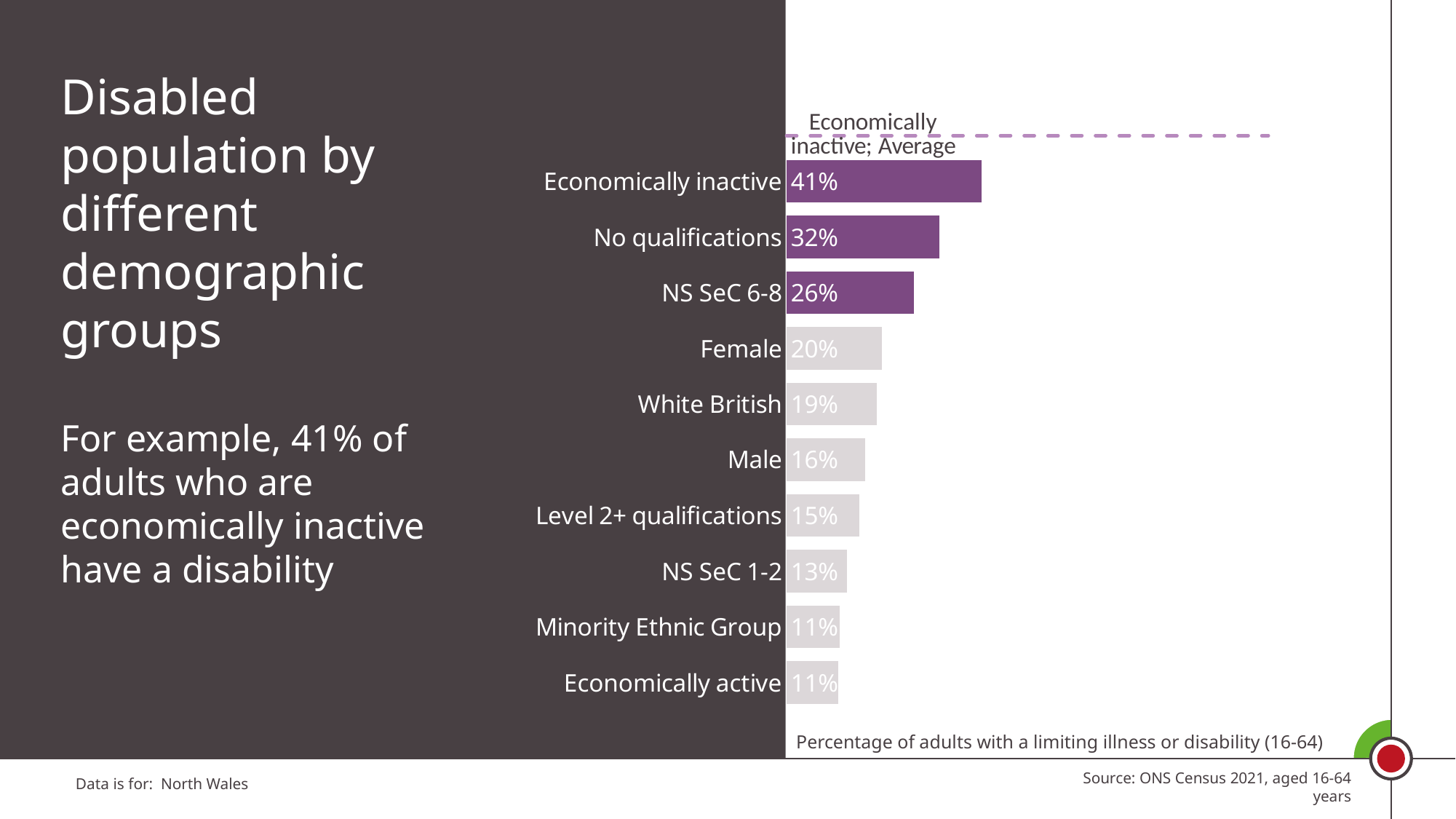
Which is larger, the value for 'White British' or the value for 'Minority Ethnic Group'? White British What is the value for 'NS SeC 6-8'? 26% What is the difference between the values for 'Female' and 'Male'? 4% What kind of chart is shown on the slide? Bar chart What percentage of economically inactive adults have a limiting illness or disability? 41% What is the value for 'Female'? 20% Which demographic group has the highest percentage of adults with a limiting illness or disability? Economically inactive How many bars are coloured purple rather than grey? 3 What is the difference between the values for 'Economically inactive' and 'Economically active'? 30% What is the value for 'Economically active'? 11% What is the value for the 'No qualifications' group? 32% How many demographic groups are shown in the chart? 10